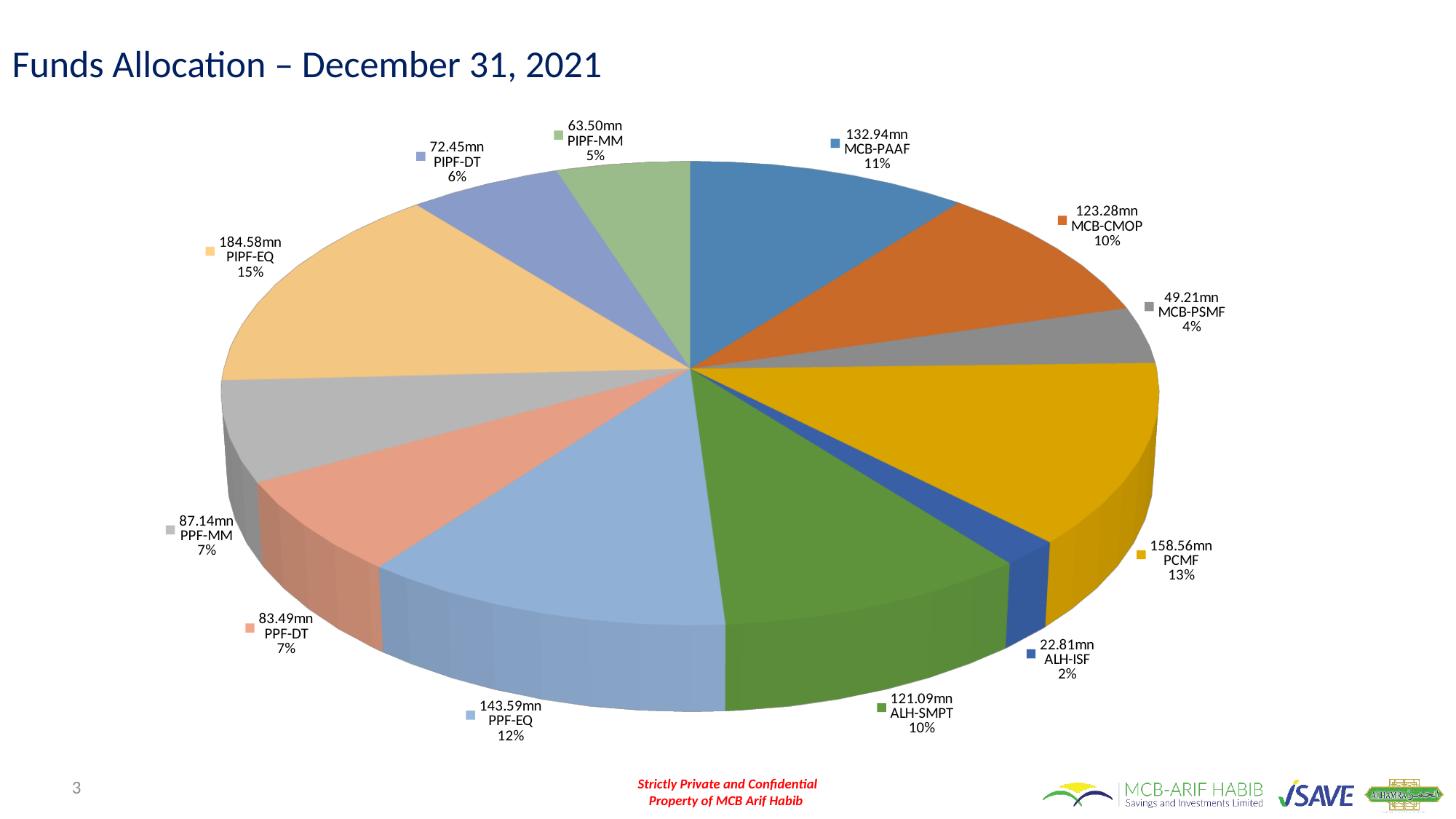
What share of the pie does PIPF-EQ represent? 15% What is the value for MCB-PSMF? 49.21mn What share of the pie does ALH-SMPT represent? 10% Which fund has the largest allocation? PIPF-EQ Which fund has the smallest allocation? ALH-ISF What is the value for PPF-DT? 83.49mn What is the value for PCMF? 158.56mn How many funds are shown in the pie chart? 12 What is the difference between the values for PCMF and PPF-EQ? 14.97mn Which is larger, the value for PPF-MM or PPF-DT? PPF-MM What type of chart is shown on the slide? Pie chart What is the title of the chart slide? Funds Allocation – December 31, 2021